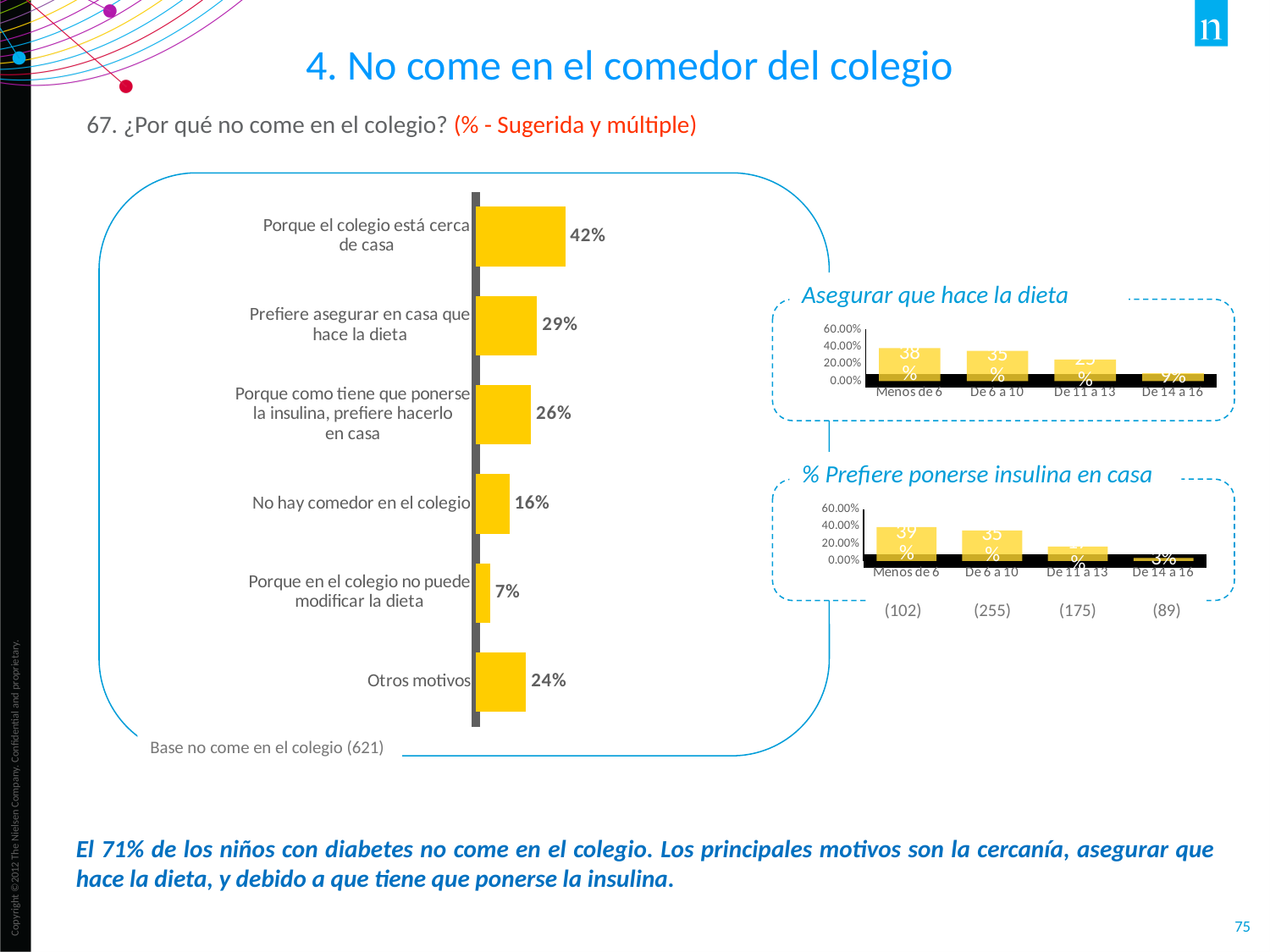
In the main bar chart on the left, what is the difference between 'Prefiere asegurar en casa que hace la dieta' and 'Porque como tiene que ponerse la insulina, prefiere hacerlo en casa'? 3% In the main bar chart on the left, what percentage is shown for 'Otros motivos'? 24% How many reasons (categories) are shown in the main bar chart on the left? 6 In the main bar chart on the left, what percentage is shown for 'No hay comedor en el colegio'? 16% In the main bar chart on the left, which reason has the lowest percentage? Porque en el colegio no puede modificar la dieta In the main bar chart on the left, what percentage is shown for 'Porque el colegio está cerca de casa'? 42% In the main bar chart on the left, which is larger: 'Otros motivos' or 'No hay comedor en el colegio'? Otros motivos In the small chart titled 'Asegurar que hace la dieta', what value is shown for 'Menos de 6'? 38% In the small chart titled '% Prefiere ponerse insulina en casa', is the value for 'De 14 a 16' greater or less than 20.00%? less What is the base (number of respondents) stated below the main bar chart? 621 In the main bar chart on the left, which reason has the highest percentage? Porque el colegio está cerca de casa What type of chart is the main chart on the left? Bar chart